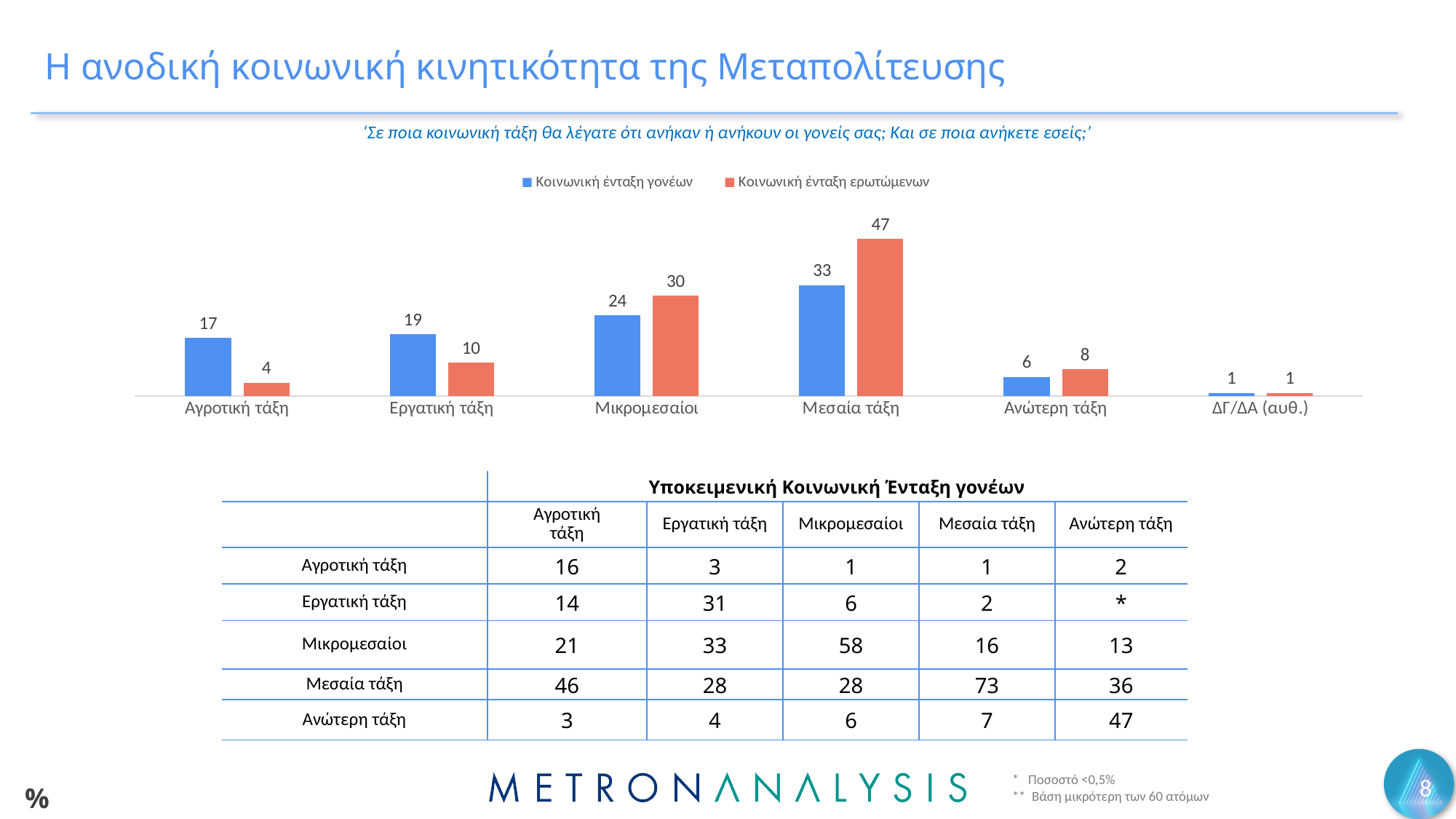
What kind of chart is shown on the slide? Bar chart Which category has the lowest value for Κοινωνική ένταξη γονέων? ΔΓ/ΔΑ (αυθ.) How many categories are shown on the x axis of the chart? 6 Which category has the highest value for Κοινωνική ένταξη ερωτώμενων? Μεσαία τάξη In the Μικρομεσαίοι category, which series has the larger value: Κοινωνική ένταξη γονέων or Κοινωνική ένταξη ερωτώμενων? Κοινωνική ένταξη ερωτώμενων How many series does the chart legend list? 2 In the Εργατική τάξη category, which series has the larger value: Κοινωνική ένταξη γονέων or Κοινωνική ένταξη ερωτώμενων? Κοινωνική ένταξη γονέων What is the value for Κοινωνική ένταξη γονέων in the Μεσαία τάξη category? 33 What is the difference between Κοινωνική ένταξη γονέων and Κοινωνική ένταξη ερωτώμενων in the Αγροτική τάξη category? 13 What is the value for Κοινωνική ένταξη ερωτώμενων in the Μικρομεσαίοι category? 30 What is the difference between Κοινωνική ένταξη ερωτώμενων and Κοινωνική ένταξη γονέων in the Μεσαία τάξη category? 14 What is the value for Κοινωνική ένταξη ερωτώμενων in the Αγροτική τάξη category? 4